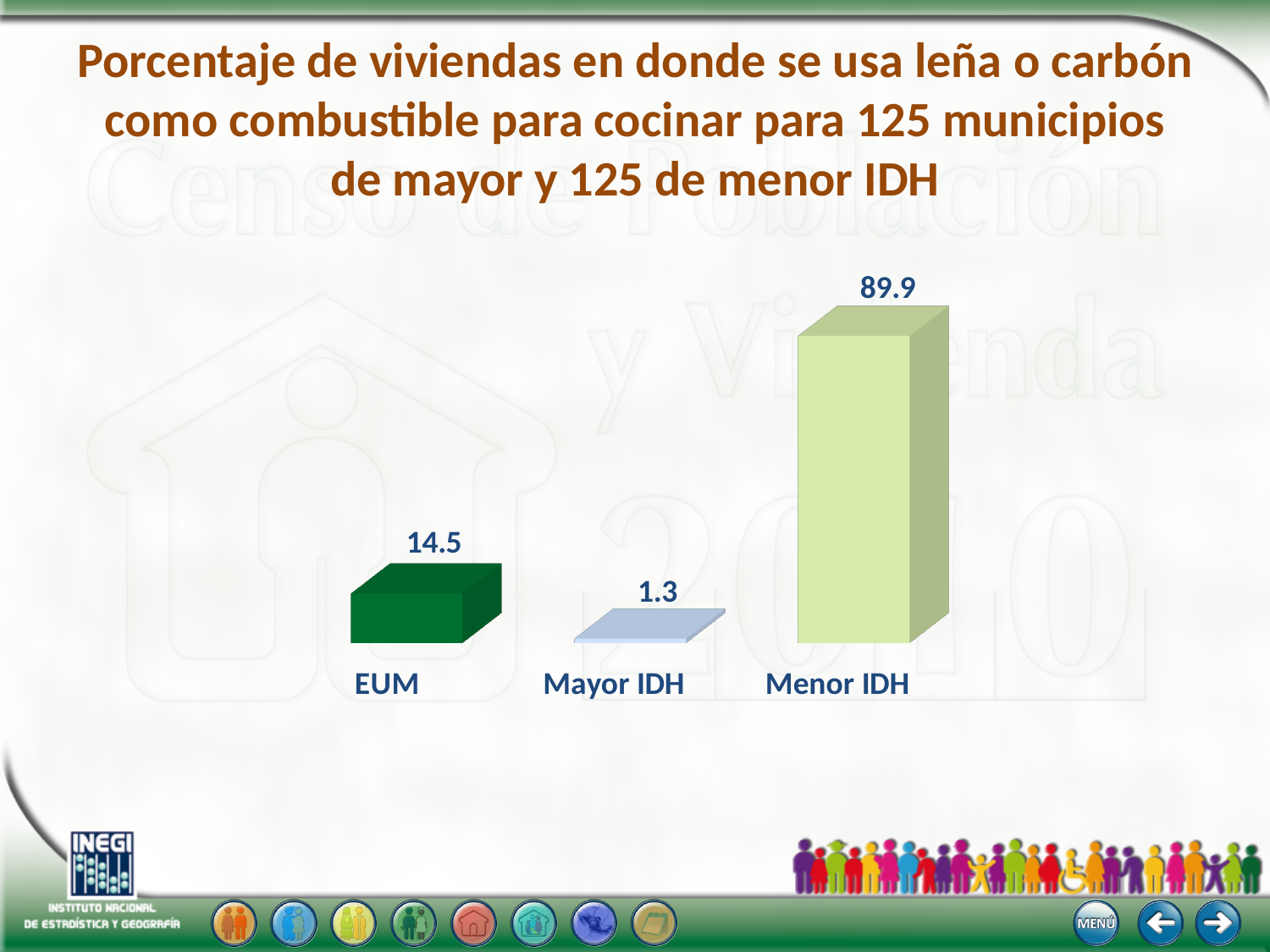
What colour is the bar for EUM? dark green What is the value for EUM? 14.5 How many categories are shown in the chart? 3 What kind of chart is shown on the slide? bar chart Which category has the highest value? Menor IDH What is the value for Mayor IDH? 1.3 What is the title of the chart? Porcentaje de viviendas en donde se usa leña o carbón como combustible para cocinar para 125 municipios de mayor y 125 de menor IDH What is the difference between the values for Menor IDH and Mayor IDH? 88.6 Which category has the lowest value? Mayor IDH What is the difference between the values for EUM and Mayor IDH? 13.2 What is the value for Menor IDH? 89.9 Which is larger, the value for EUM or the value for Mayor IDH? EUM